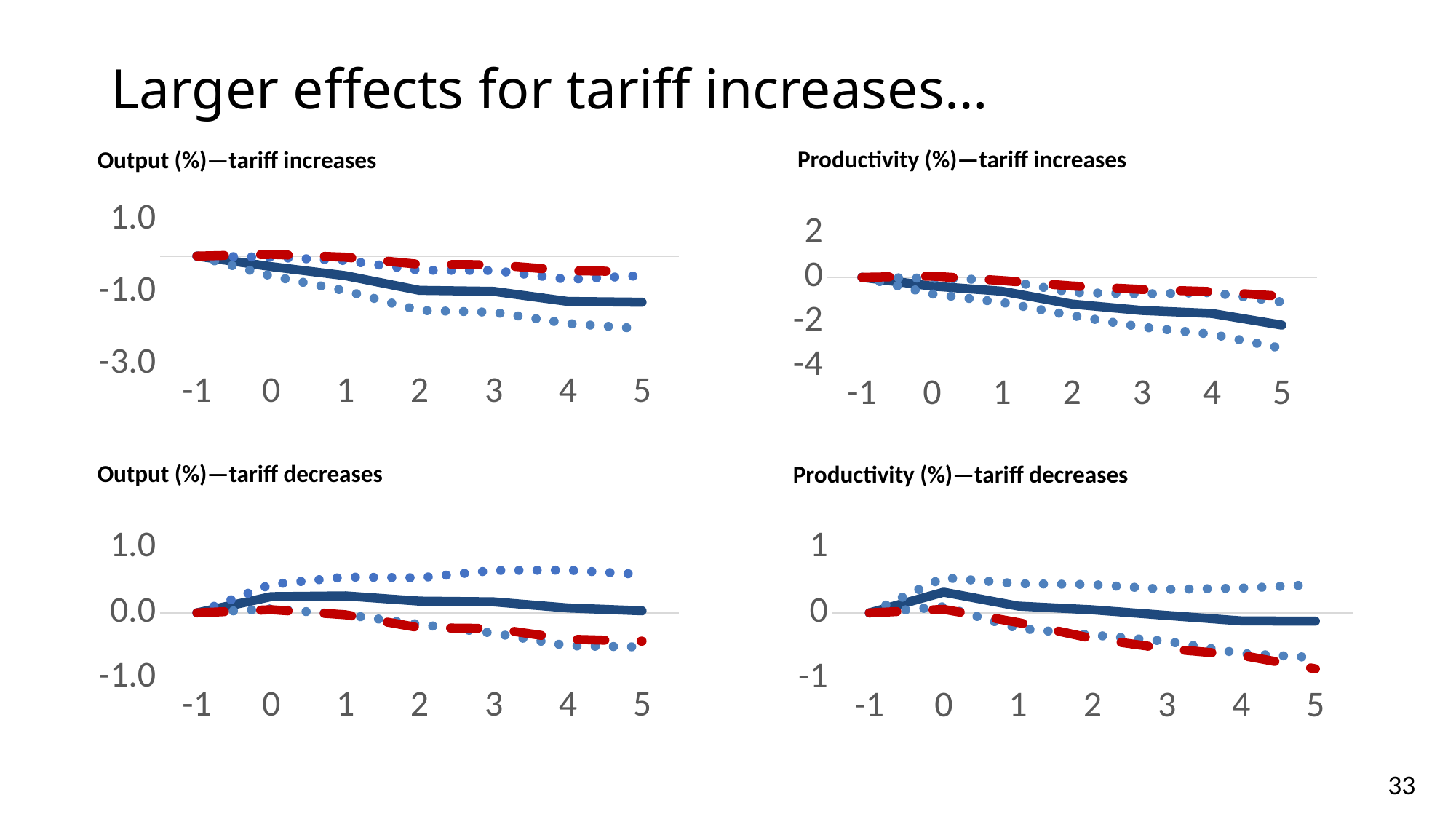
What is the lowest y-axis tick label shown on the 'Productivity (%)—tariff increases' chart? -4 In the 'Output (%)—tariff increases' chart, is the solid line higher at x = -1 or at x = 5? x = -1 In the 'Productivity (%)—tariff increases' chart, does the solid line rise or fall as x goes from -1 to 5? fall What kind of chart is the 'Output (%)—tariff increases' chart? line chart In the 'Productivity (%)—tariff increases' chart, how many x-axis tick labels are shown? 7 In the 'Output (%)—tariff increases' chart, does the solid line rise or fall as x goes from -1 to 5? fall What is the title of the chart in the bottom-right position of the slide? Productivity (%)—tariff decreases In the 'Productivity (%)—tariff increases' chart, is the value of the lower dotted line at x = 5 greater or less than -2? less In the 'Output (%)—tariff increases' chart, is the value of the lower dotted line at x = 5 greater or less than -1.0? less In the 'Output (%)—tariff decreases' chart, is the value of the upper dotted line at x = 5 greater or less than 0.0? greater How many charts are shown on the slide? 4